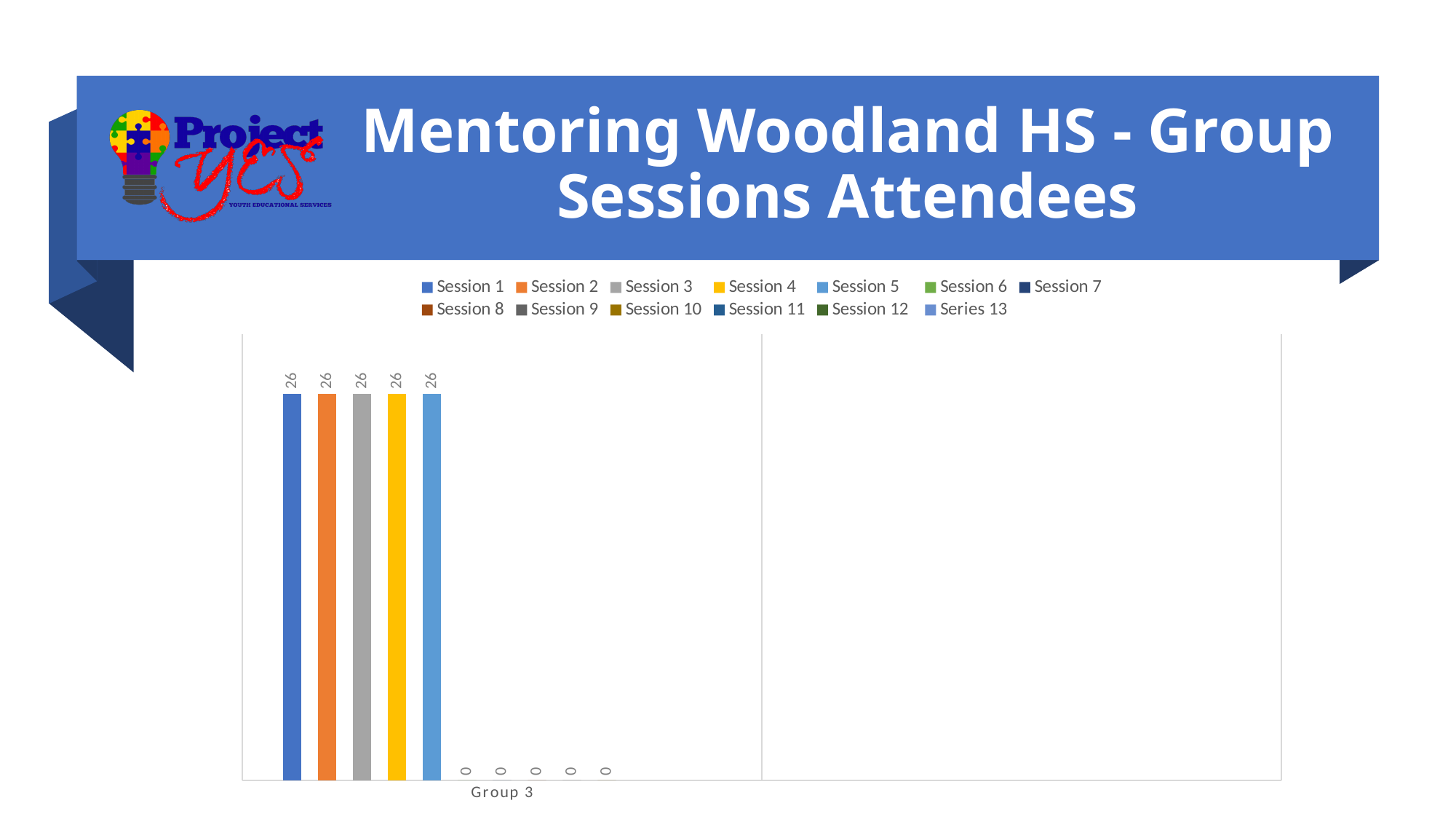
What is the value for Session 3 in Group 3? 26 What is the value for Session 1 in Group 3? 26 How many series does the legend list? 13 What is the name of the category shown on the x axis? Group 3 What kind of chart is shown on the slide? Bar chart What is the value for Session 5 in Group 3? 26 Which is larger for Group 3, Session 2 or Session 7? Session 2 What is the difference between the Session 4 value and the Session 8 value for Group 3? 26 What is the title of the slide? Mentoring Woodland HS - Group Sessions Attendees What is the value for Session 6 in Group 3? 0 How many categories are shown on the x axis? 1 How many series have a value of 26 in Group 3? 5